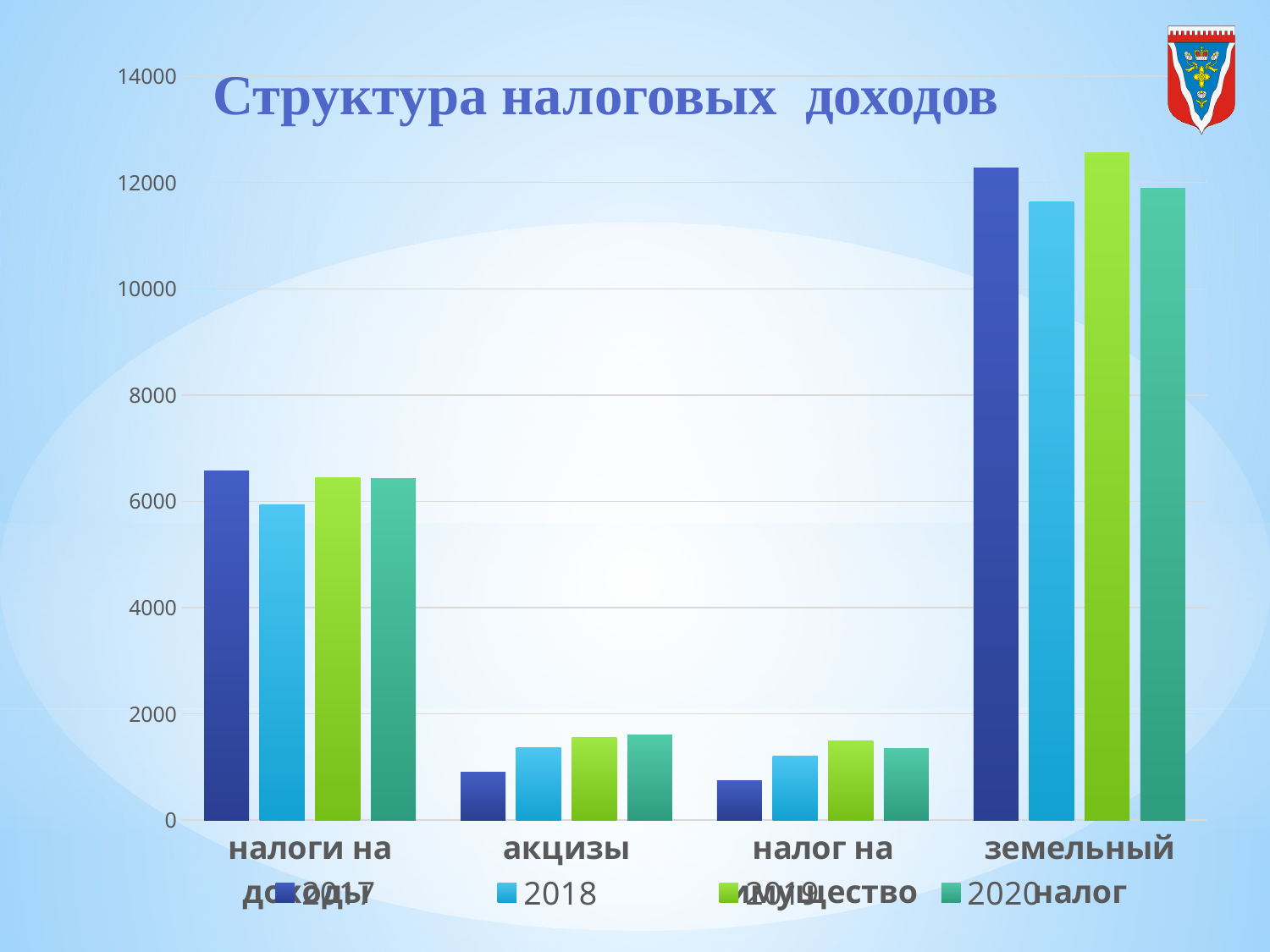
Which is larger for земельный налог: the 2019 value or the 2018 value? 2019 What kind of chart is shown on the slide? bar chart Is the value for налоги на доходы in 2017 greater or less than 6000? greater What is the title of the chart? Структура налоговых доходов Is the value for земельный налог in 2018 greater or less than 12000? less Which category has the highest values in the chart? земельный налог Is the value for земельный налог in 2019 greater or less than 12000? greater Which is larger for налоги на доходы: the 2017 value or the 2018 value? 2017 How many categories are shown on the x axis? 4 How many series does the legend list? 4 Which year has the tallest bar for земельный налог? 2019